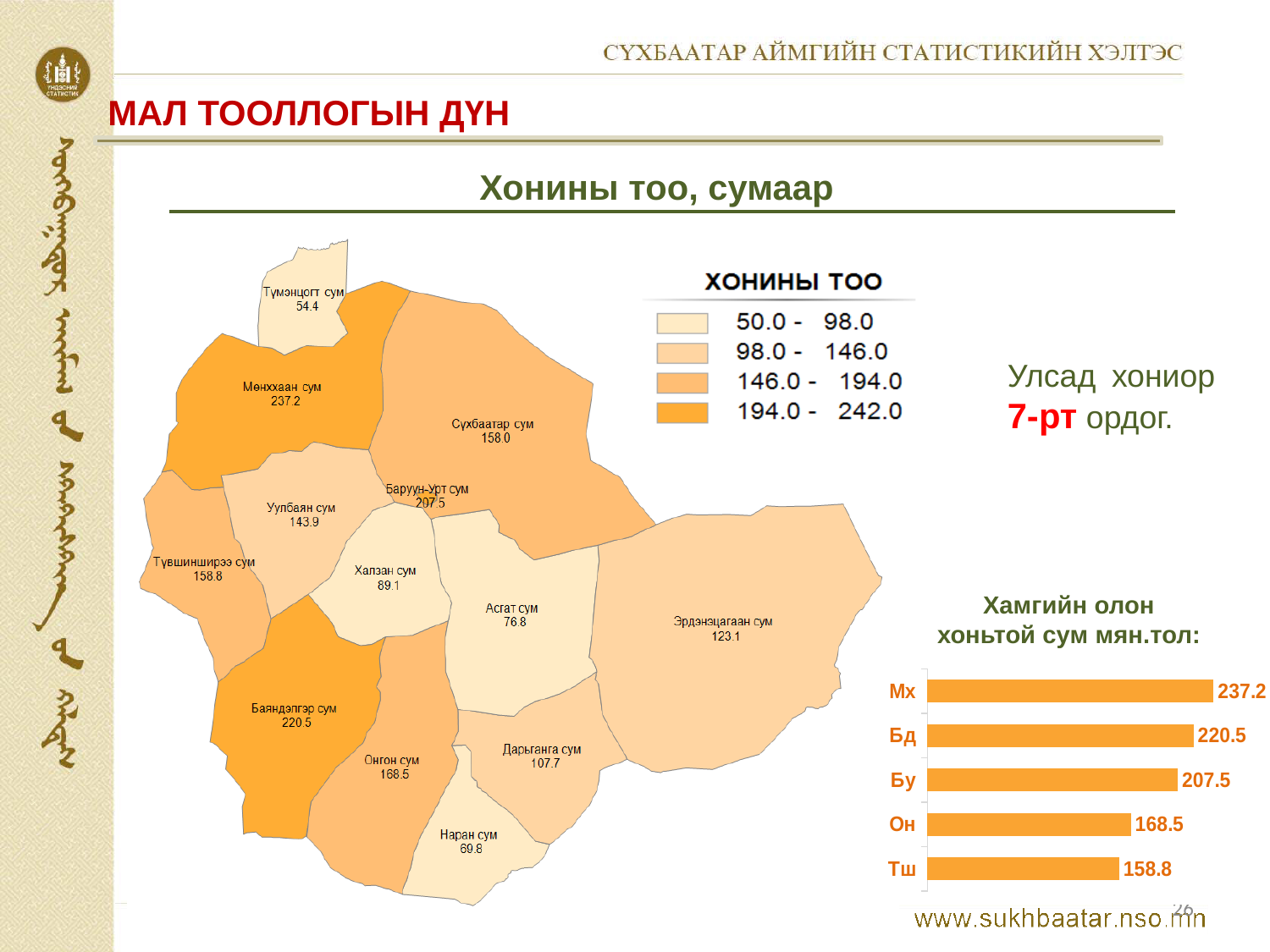
How many categories are shown in the bar chart titled 'Хамгийн олон хоньтой сум мян.тол:'? 5 In the bar chart titled 'Хамгийн олон хоньтой сум мян.тол:', do the values rise or fall from the top bar to the bottom bar? Fall What kind of chart is the one titled 'Хамгийн олон хоньтой сум мян.тол:'? Bar chart In the bar chart titled 'Хамгийн олон хоньтой сум мян.тол:', which category has the lowest value? Тш In the bar chart titled 'Хамгийн олон хоньтой сум мян.тол:', what is the value for Мх? 237.2 In the bar chart titled 'Хамгийн олон хоньтой сум мян.тол:', what is the value for Тш? 158.8 In the bar chart titled 'Хамгийн олон хоньтой сум мян.тол:', what is the difference between the values for Мх and Бд? 16.7 On the map titled 'Хонины тоо, сумаар', how many value ranges does the legend 'ХОНИНЫ ТОО' list? 4 In the bar chart titled 'Хамгийн олон хоньтой сум мян.тол:', which is larger, the value for Он or the value for Тш? Он In the bar chart titled 'Хамгийн олон хоньтой сум мян.тол:', what is the value for Бу? 207.5 In the bar chart titled 'Хамгийн олон хоньтой сум мян.тол:', which category has the highest value? Мх On the map titled 'Хонины тоо, сумаар', what value is shown for Эрдэнэцагаан сум? 123.1